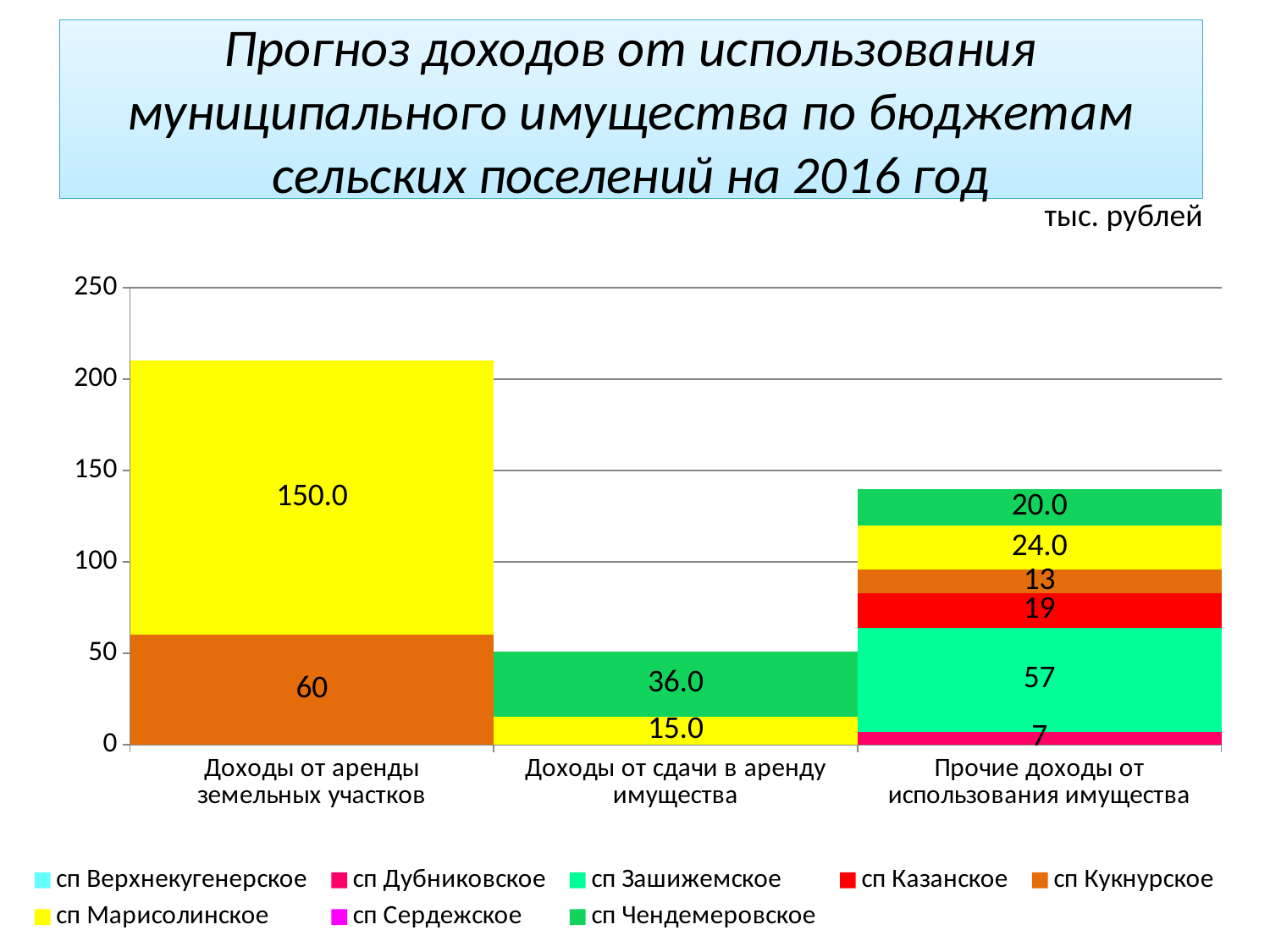
Which category has the tallest stacked bar? Доходы от аренды земельных участков What is the value for сп Казанское in the 'Прочие доходы от использования имущества' bar? 19 What is the total of the stacked bar for 'Доходы от сдачи в аренду имущества'? 51.0 What kind of chart is shown on the slide? Stacked bar chart What is the value for сп Чендемеровское in the 'Доходы от сдачи в аренду имущества' bar? 36.0 What is the value for сп Кукнурское in the 'Доходы от аренды земельных участков' bar? 60 What is the value for сп Зашижемское in the 'Прочие доходы от использования имущества' bar? 57 How many series does the legend list? 8 In the 'Доходы от сдачи в аренду имущества' bar, which is larger: сп Чендемеровское or сп Марисолинское? сп Чендемеровское What is the value for сп Марисолинское in the 'Доходы от аренды земельных участков' bar? 150.0 What is the difference between the сп Марисолинское and сп Кукнурское values in the 'Доходы от аренды земельных участков' bar? 90 What is the total of the stacked bar for 'Доходы от аренды земельных участков'? 210